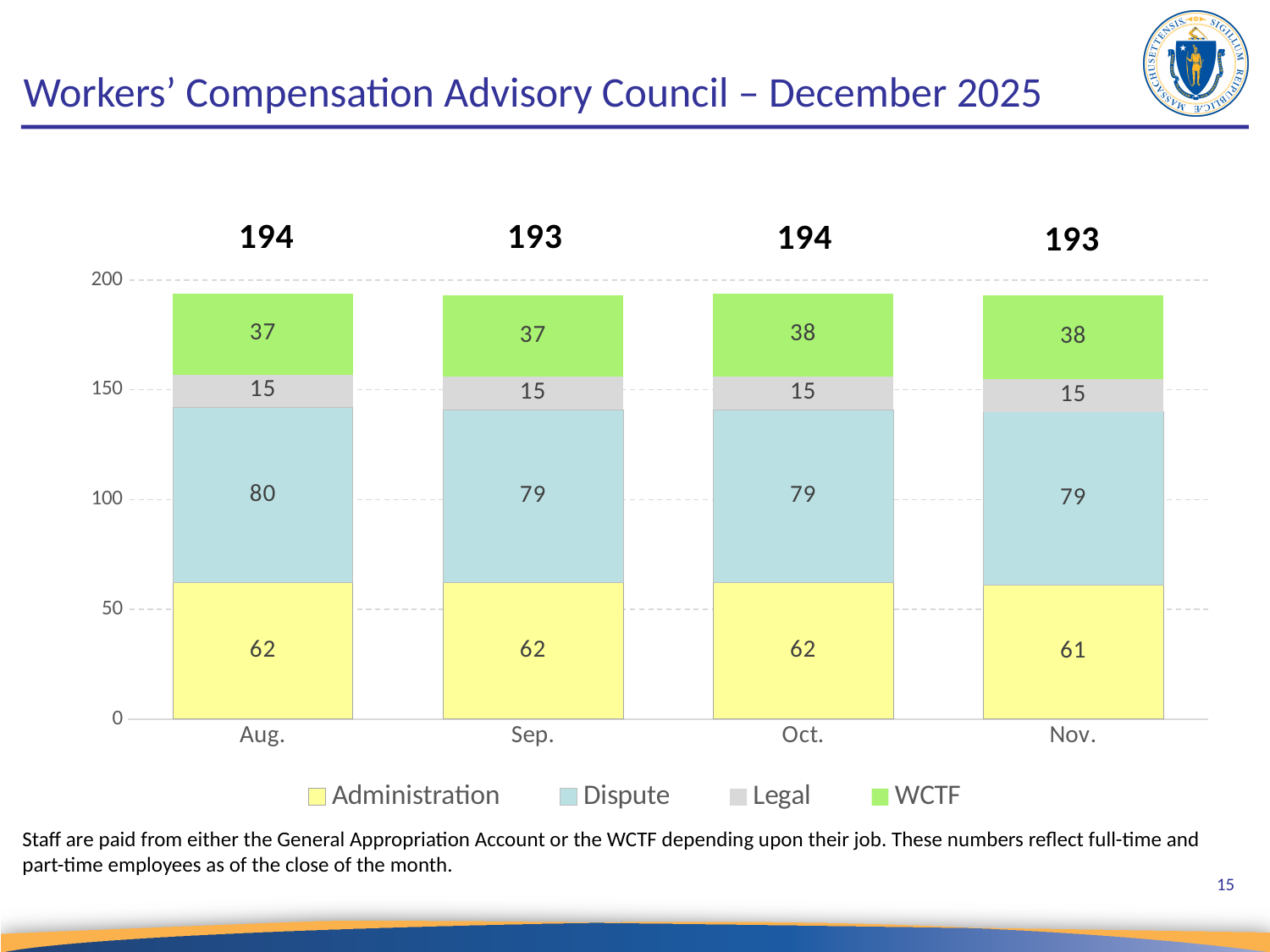
What is the difference between the Dispute value for Aug. and the Dispute value for Sep.? 1 What is the Dispute value for Aug.? 80 What is the total of the stacked bar for Sep.? 193 What is the Legal value for Sep.? 15 How many months are shown on the x axis? 4 What is the total of the stacked bar for Oct.? 194 What is the WCTF value for Oct.? 38 Which series is shown in green in the legend? WCTF How many series does the legend list? 4 What is the Administration value for Nov.? 61 Which is larger in Nov., the Administration value or the WCTF value? Administration What kind of chart is shown on the slide? Stacked bar chart